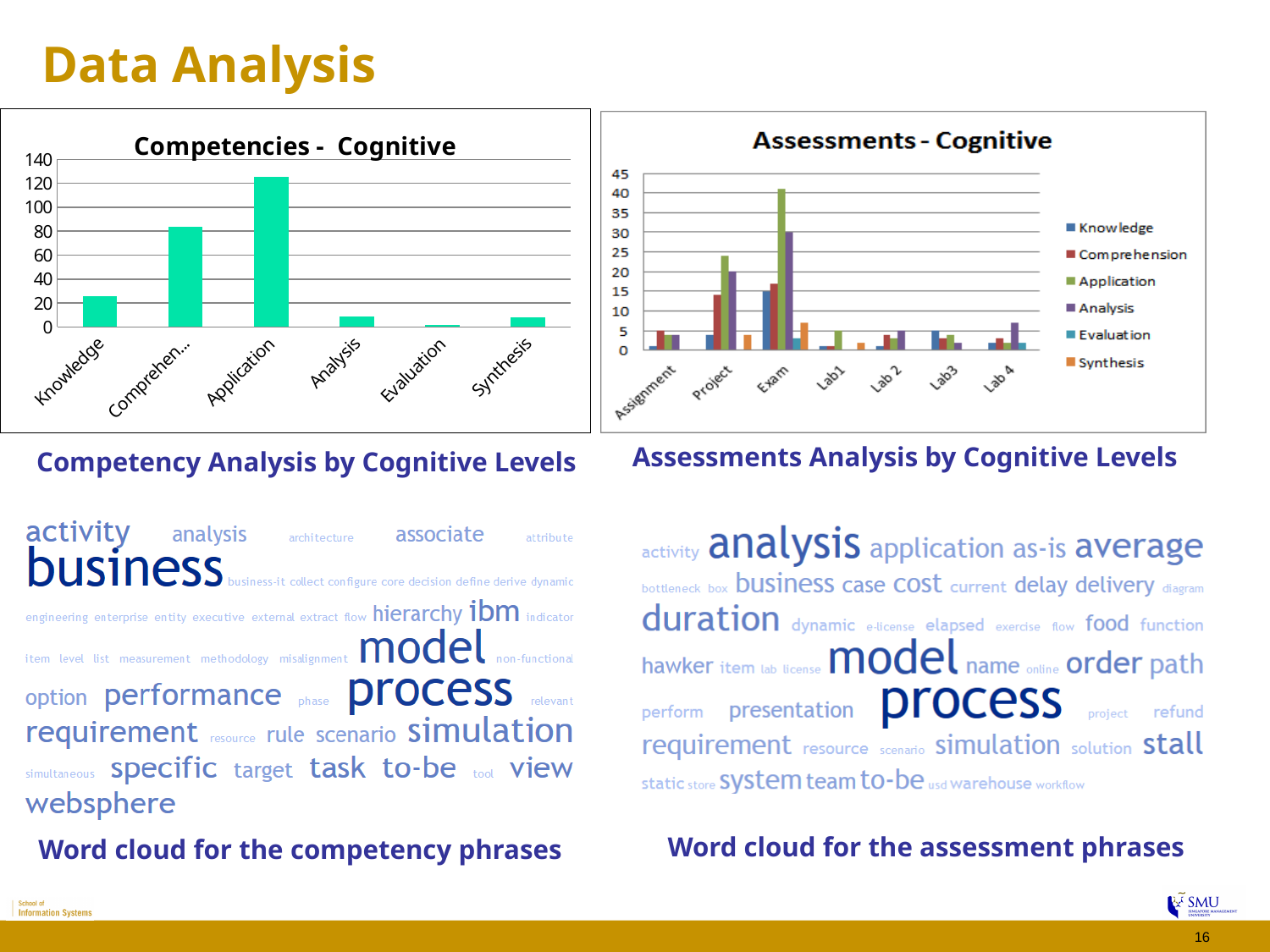
In the Competencies - Cognitive chart, is the value for Knowledge greater or less than 40? less How many categories are shown on the x axis of the Competencies - Cognitive chart? 6 In the Competencies - Cognitive chart, which category has the highest value? Application In the Assessments - Cognitive chart, which category has the tallest bar overall? Exam How many series does the legend of the Assessments - Cognitive chart list? 6 In the Competencies - Cognitive chart, is the value for Application greater or less than 120? greater In the Competencies - Cognitive chart, which is larger, the value for Knowledge or the value for Analysis? Knowledge In the Assessments - Cognitive chart, is the Application value for Exam greater or less than 35? greater How many categories are shown on the x axis of the Assessments - Cognitive chart? 7 In the Competencies - Cognitive chart, which category has the lowest value? Evaluation What kind of chart is the Competencies - Cognitive chart? bar chart